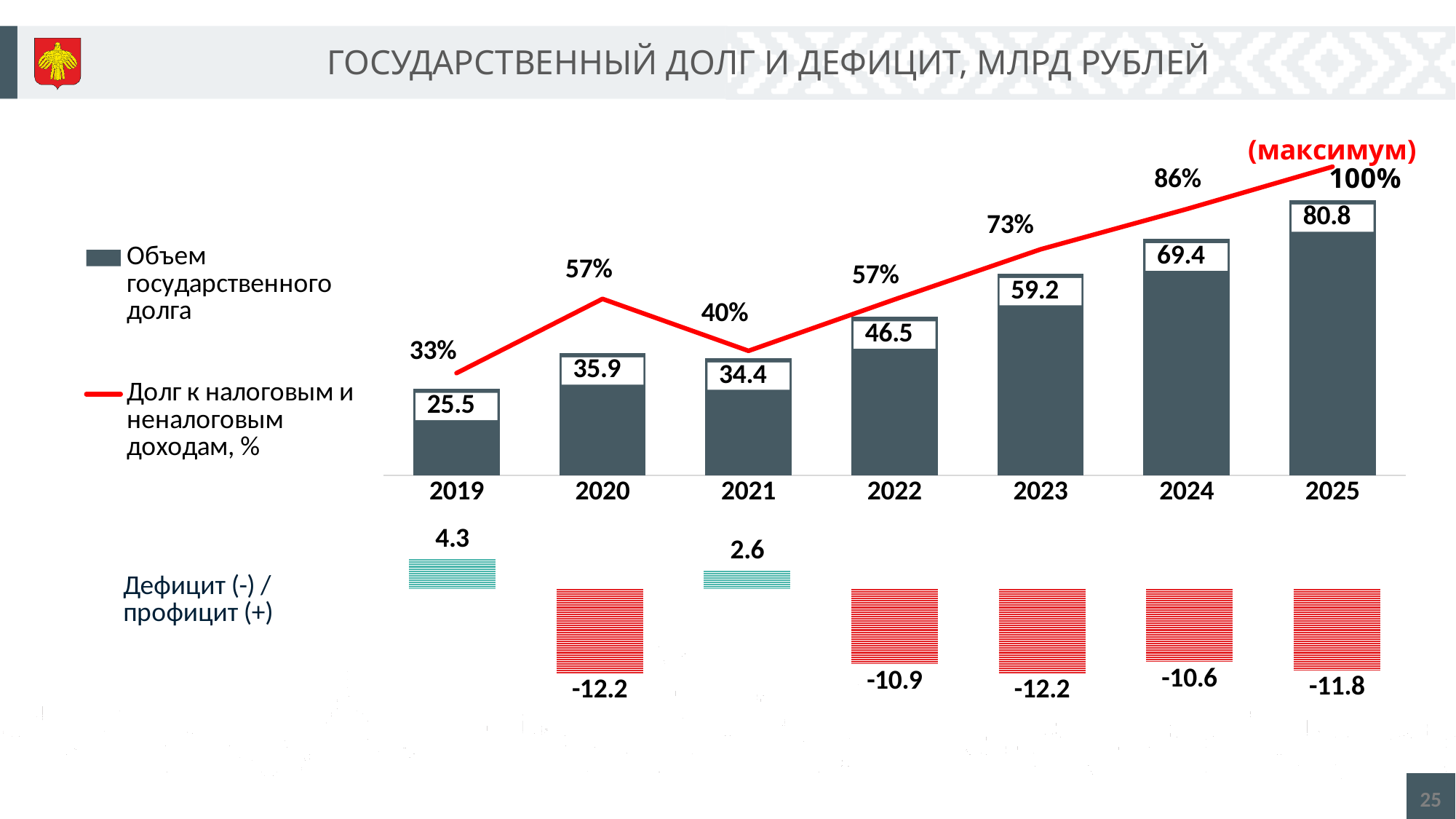
What is the overall trend of "Объем государственного долга" from 2021 to 2025 in the upper chart? rising In the upper chart, which year has the lowest value of "Объем государственного долга"? 2019 How many series does the legend of the upper chart list? 2 In the upper chart, what is the value of "Объем государственного долга" for 2019? 25.5 In the lower chart "Дефицит (-) / профицит (+)", what is the value for 2022? -10.9 In the lower chart "Дефицит (-) / профицит (+)", which year has the highest value? 2019 In the upper chart, what is the value of "Долг к налоговым и неналоговым доходам, %" for 2023? 73% In the upper chart, what is the value of "Объем государственного долга" for 2025? 80.8 In the upper chart, what is the difference between the "Объем государственного долга" values for 2025 and 2024? 11.4 In the upper chart, which is larger, the "Объем государственного долга" value for 2020 or for 2021? 2020 In the upper chart, which year has the highest value of "Долг к налоговым и неналоговым доходам, %"? 2025 How many years are shown on the x axis of the upper chart? 7